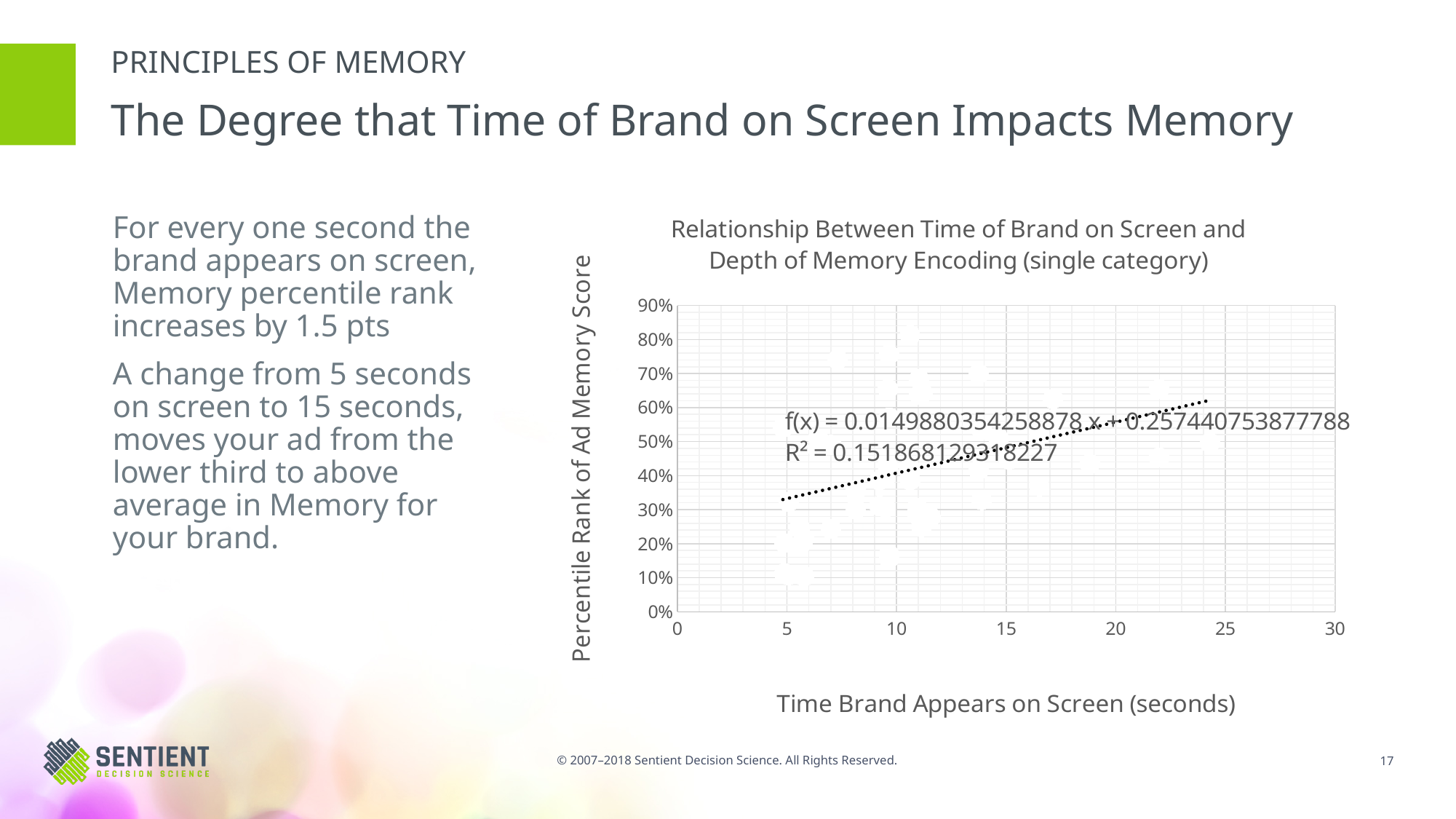
What is the R² value printed on the chart? R² = 0.151868129318227 Is the trendline value at 5 seconds greater or less than 40%? Less What is the title of the chart? Relationship Between Time of Brand on Screen and Depth of Memory Encoding (single category) Is the trendline value at 10 seconds greater or less than 50%? Less Does the dotted trendline rise or fall as time on screen increases? Rise What is the highest value shown on the x axis of the chart? 30 What is the highest value shown on the y axis of the chart? 90% What kind of chart is shown on the slide? Scatter chart What is the trendline equation printed on the chart? f(x) = 0.0149880354258878 x + 0.257440753877788 What is the label of the x axis of the chart? Time Brand Appears on Screen (seconds) Is the trendline value at 20 seconds greater or less than 50%? Greater